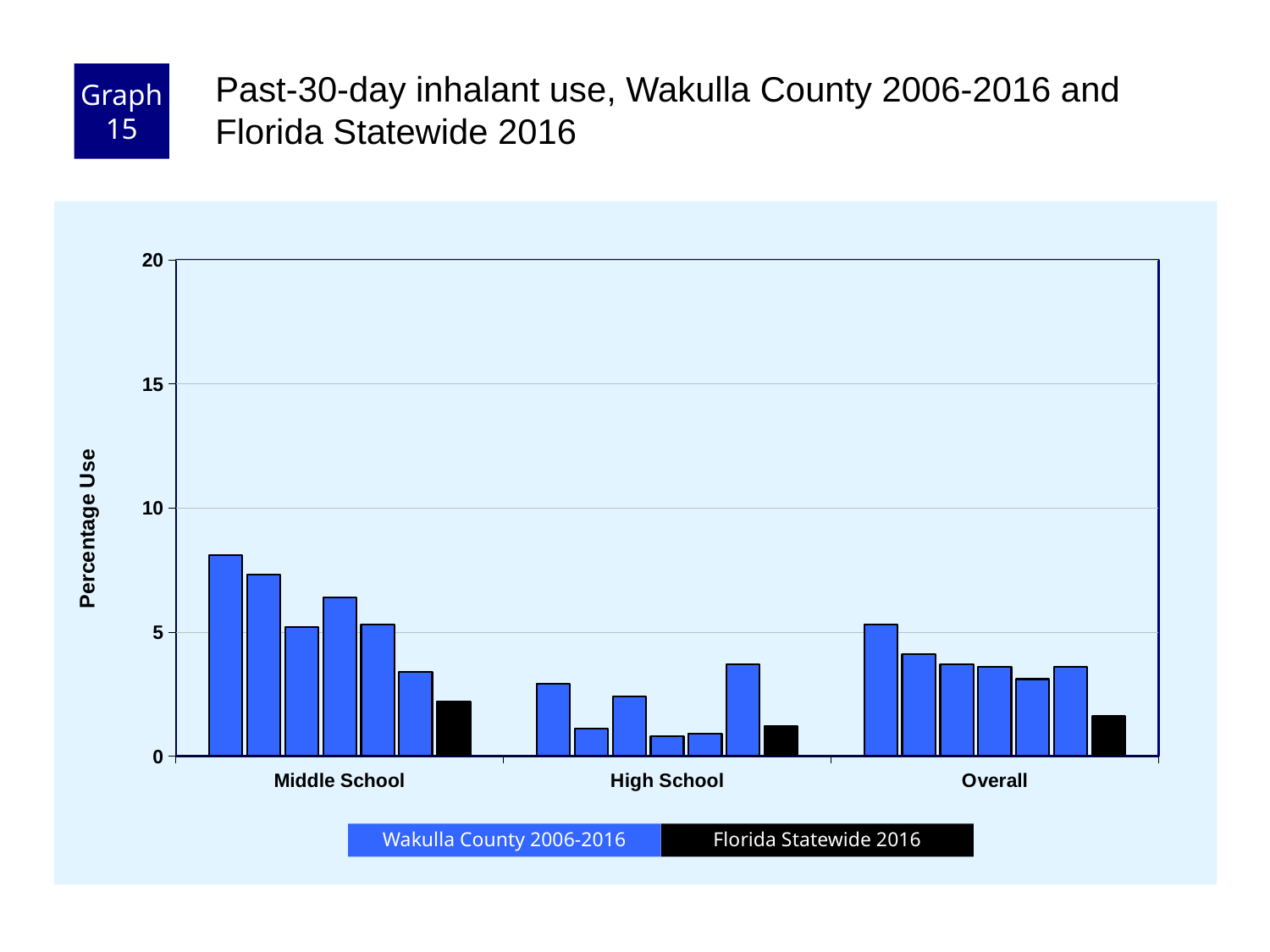
What kind of chart is shown on the slide? bar chart Do the Wakulla County bars for Overall generally rise or fall from the first to the last bar? fall Which category contains the tallest bar in the chart? Middle School In which category is the Florida Statewide 2016 bar the lowest? High School What colour represents Florida Statewide 2016 in the legend? black How many categories are shown on the x axis? 3 Is the first Wakulla County bar for Middle School greater or less than 5? greater Is the Florida Statewide 2016 bar for Middle School larger or smaller than the Florida Statewide 2016 bar for High School? larger What is the title of the y axis? Percentage Use Is the tallest Wakulla County bar for High School greater or less than 5? less How many series does the legend list? 2 Is the Florida Statewide 2016 value for Overall greater or less than 5? less